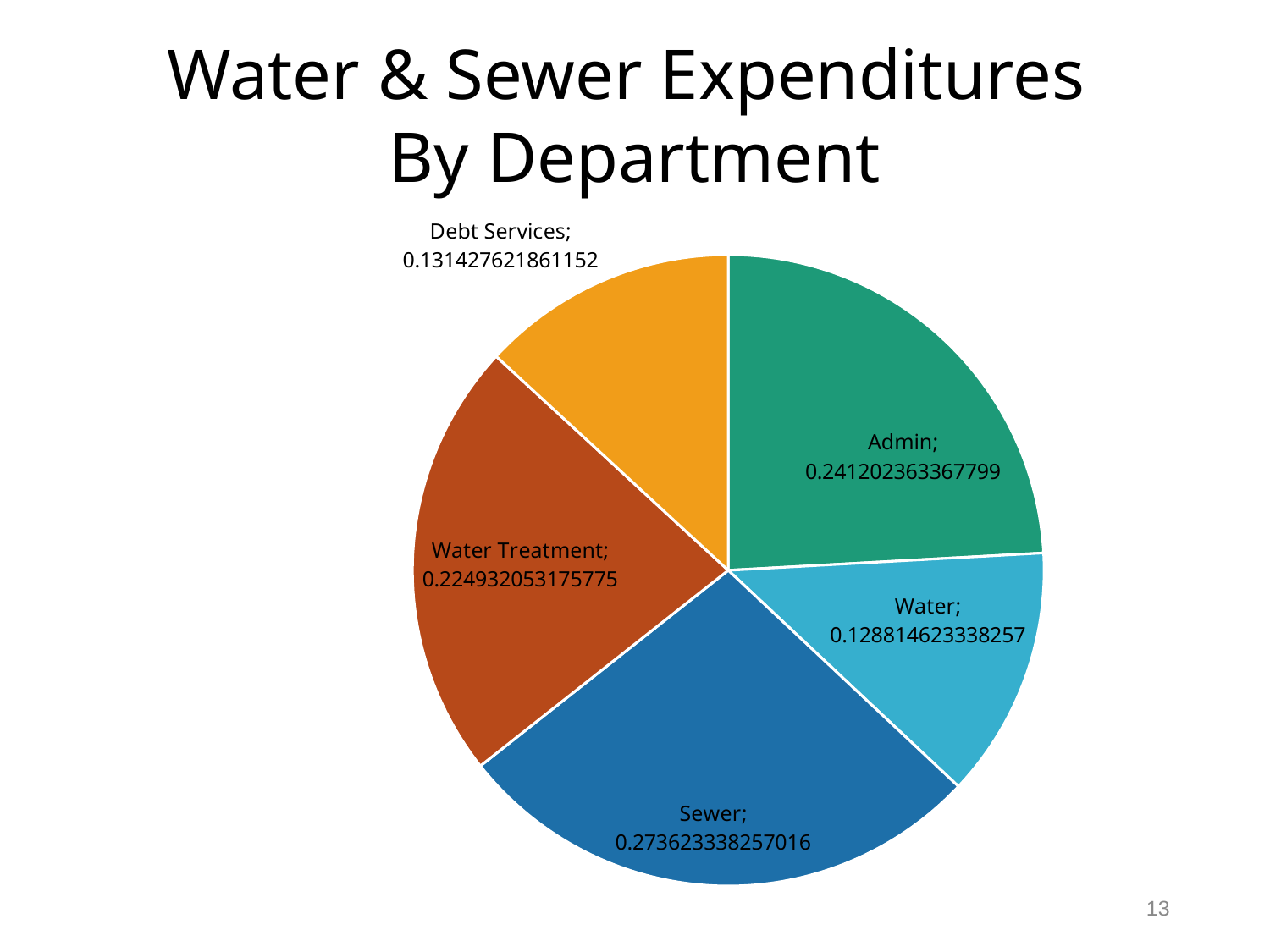
What is the difference between the Sewer value and the Admin value? 0.032420974889217 What is the value shown for the Sewer slice? 0.273623338257016 What is the value shown for the Debt Services slice? 0.131427621861152 What is the title of the chart? Water & Sewer Expenditures By Department What kind of chart is shown on the slide? pie chart Which department has the largest slice of the pie? Sewer What is the value shown for the Water slice? 0.128814623338257 Which is larger, the Admin slice or the Water Treatment slice? Admin What is the value shown for the Water Treatment slice? 0.224932053175775 What is the value shown for the Admin slice? 0.241202363367799 Which department has the smallest slice of the pie? Water How many slices does the pie chart have? 5